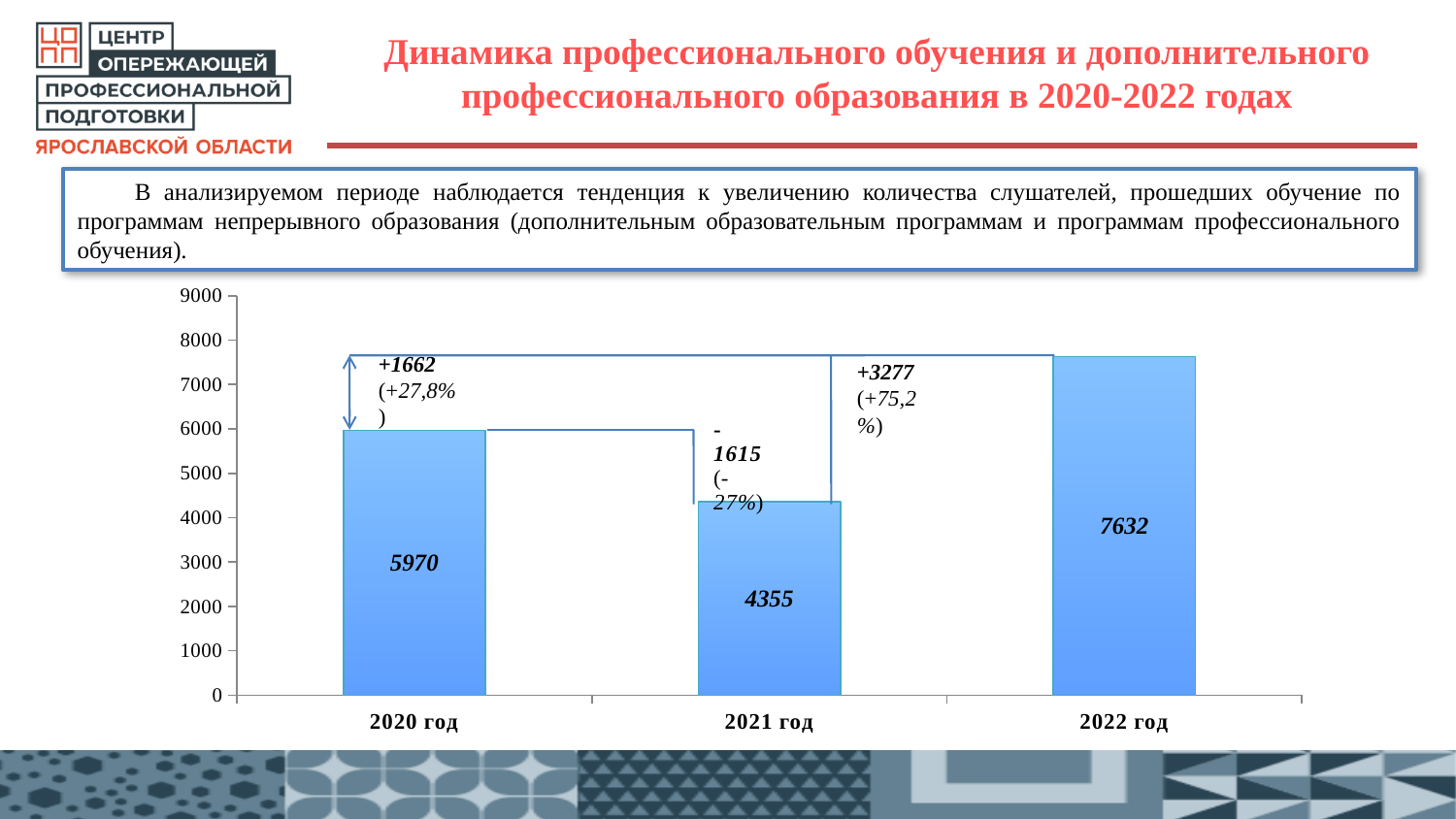
What is the value for 2022 год? 7632 Which year has the lowest value? 2021 год Which is larger, the value for 2020 год or the value for 2021 год? 2020 год Which year has the highest value? 2022 год Is the value for 2022 год greater or less than 7000? greater What kind of chart is shown on the slide? bar chart What is the value for 2020 год? 5970 What is the difference between the values for 2020 год and 2021 год? 1615 How many years are shown on the x axis? 3 What is the difference between the values for 2022 год and 2021 год? 3277 What is the value for 2021 год? 4355 Does the value rise or fall from 2021 год to 2022 год? rise